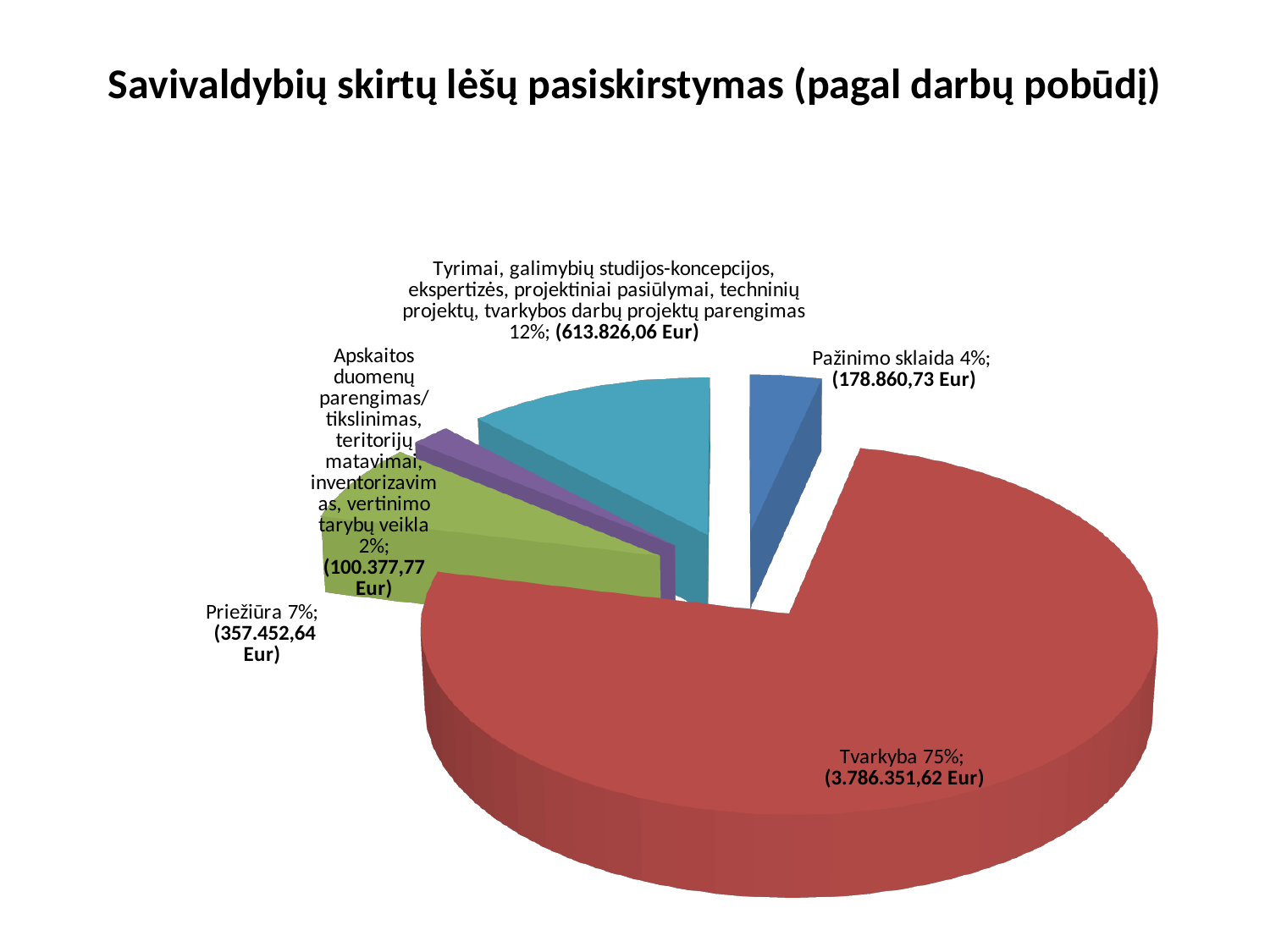
What is the difference in percentage points between the Tvarkyba share and the Tyrimai, galimybių studijos-koncepcijos, ekspertizės, projektiniai pasiūlymai, techninių projektų, tvarkybos darbų projektų parengimas share? 63 percentage points Which category has the largest share of the pie? Tvarkyba What is the amount in Eur for Pažinimo sklaida? 178.860,73 Eur What share of the pie does Tvarkyba represent? 75% What share of the pie does Priežiūra represent? 7% What is the title of the chart? Savivaldybių skirtų lėšų pasiskirstymas (pagal darbų pobūdį) What kind of chart is shown on the slide? pie chart What is the amount in Eur for Priežiūra? 357.452,64 Eur How many slices does the pie chart have? 5 What is the amount in Eur for Tvarkyba? 3.786.351,62 Eur Which has a larger share: Pažinimo sklaida or Priežiūra? Priežiūra Which category has the smallest share of the pie? Apskaitos duomenų parengimas/tikslinimas, teritorijų matavimai, inventorizavimas, vertinimo tarybų veikla